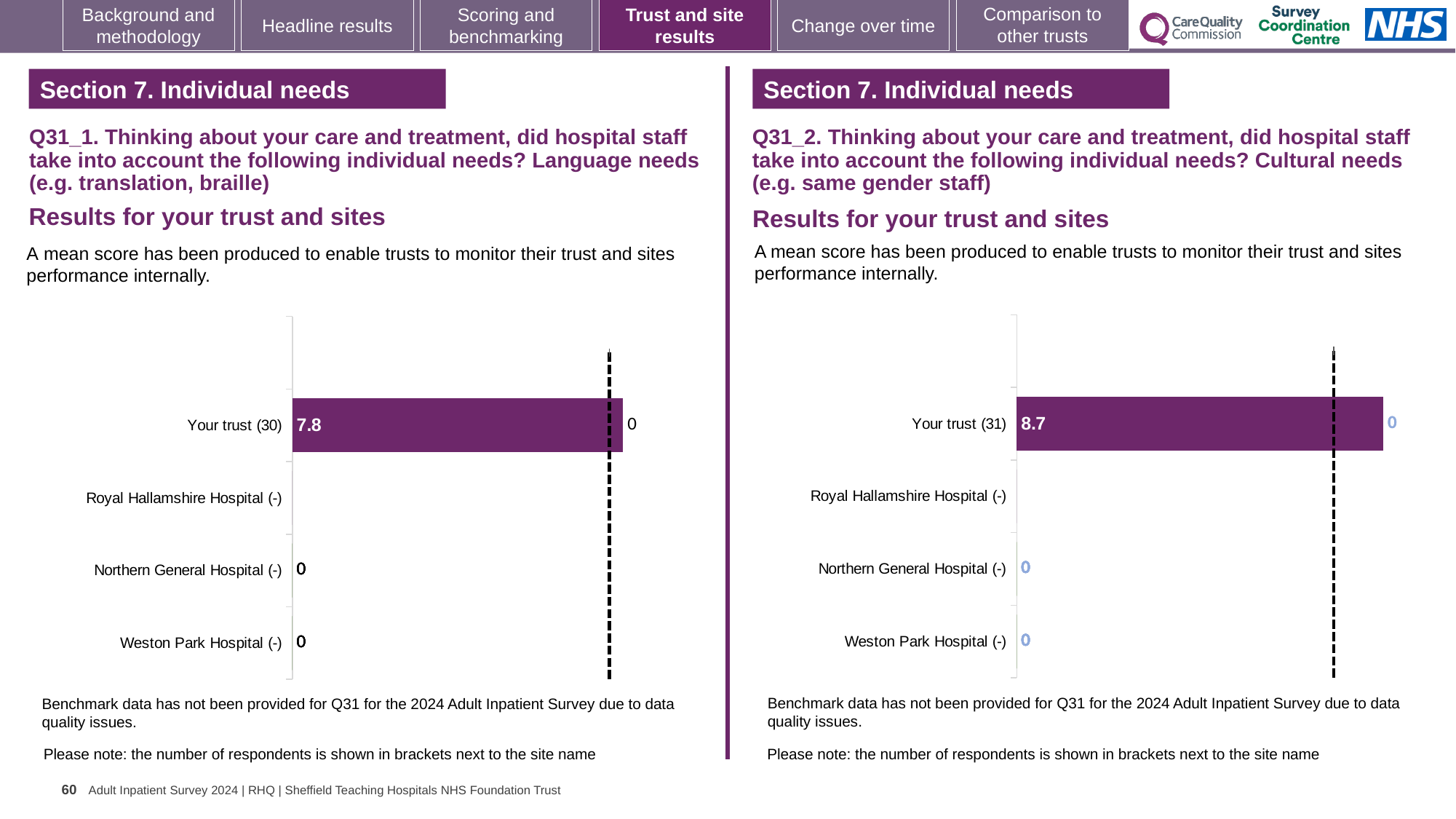
In the right chart (Q31_2, Cultural needs), how many categories are listed on the vertical axis? 4 What is the difference between the Your trust score in the right chart (Q31_2) and the Your trust score in the left chart (Q31_1)? 0.9 In the left chart (Q31_1, Language needs), how many respondents are shown in brackets for Your trust? 30 In the right chart (Q31_2, Cultural needs), which category has the highest mean score? Your trust (31) In the right chart (Q31_2, Cultural needs), what is the mean score for Your trust? 8.7 In the left chart (Q31_1, Language needs), what is the mean score for Your trust? 7.8 What kind of chart is used in the left chart (Q31_1, Language needs)? Bar chart Which is larger: the Your trust score in the left chart (Q31_1) or the Your trust score in the right chart (Q31_2)? Q31_2 (8.7) In the left chart (Q31_1, Language needs), how many categories are listed on the vertical axis? 4 In the right chart (Q31_2, Cultural needs), what value is shown for Northern General Hospital? 0 In the left chart (Q31_1, Language needs), which category has the highest mean score? Your trust (30) In the right chart (Q31_2, Cultural needs), how many respondents are shown in brackets for Your trust? 31